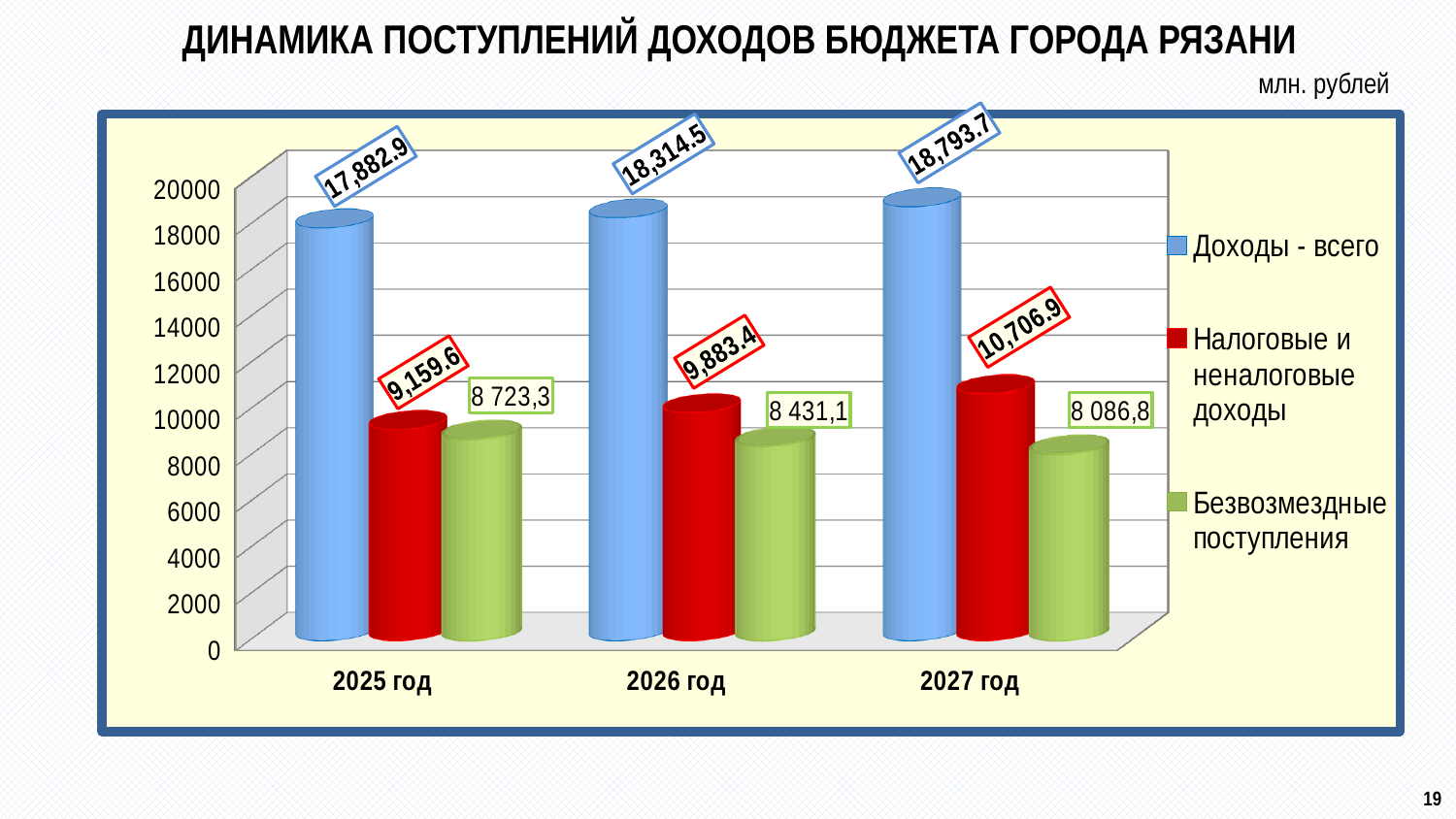
What is the difference between Налоговые и неналоговые доходы in 2027 год and in 2025 год? 1,547.3 How many years are shown on the x axis? 3 What is the value of Налоговые и неналоговые доходы for 2027 год? 10,706.9 Which is larger in 2026 год: Налоговые и неналоговые доходы or Безвозмездные поступления? Налоговые и неналоговые доходы In which year is Доходы - всего the highest? 2027 год What kind of chart is shown on the slide? Bar chart What is the value of Доходы - всего for 2025 год? 17,882.9 Do the values of Безвозмездные поступления rise or fall from 2025 год to 2027 год? Fall What is the value of Безвозмездные поступления for 2026 год? 8 431,1 In which year is Безвозмездные поступления the lowest? 2027 год What is the difference between Доходы - всего in 2027 год and in 2025 год? 910.8 How many series does the legend list? 3